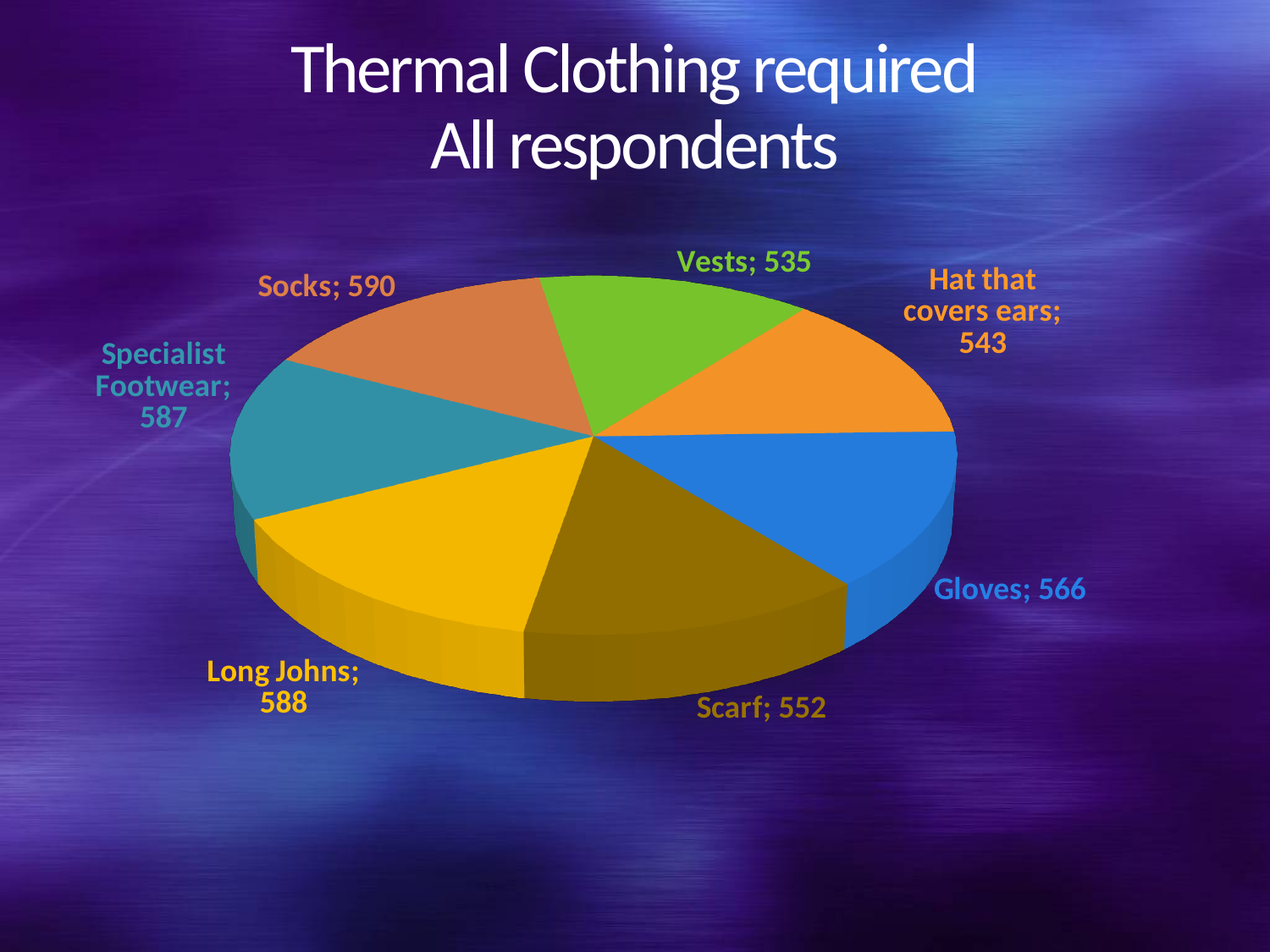
What is the value for Long Johns? 588 Which is larger, the value for Scarf or the value for Hat that covers ears? Scarf What is the value for Gloves? 566 What kind of chart is shown on the slide? Pie chart What is the value for Hat that covers ears? 543 Which category has the lowest value? Vests What is the value for Socks? 590 Which category has the highest value? Socks What is the title of the chart? Thermal Clothing required All respondents What is the difference between the values for Socks and Vests? 55 How many categories are shown in the pie chart? 7 What is the difference between the values for Gloves and Scarf? 14